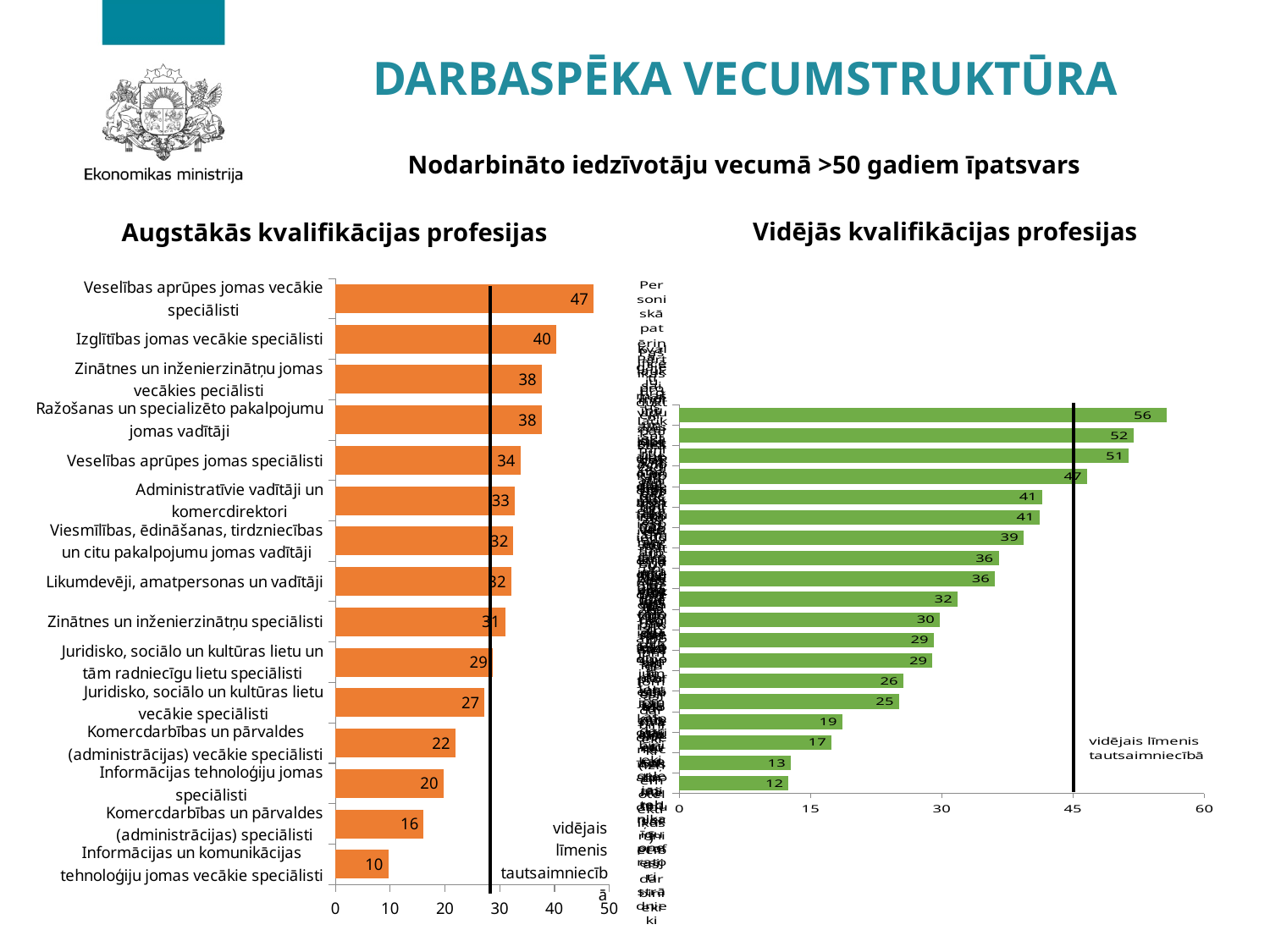
What kind of chart is 'Augstākās kvalifikācijas profesijas'? Bar chart In the chart 'Augstākās kvalifikācijas profesijas', what is the difference between 'Izglītības jomas vecākie speciālisti' and 'Komercdarbības un pārvaldes (administrācijas) speciālisti'? 24 In the chart 'Augstākās kvalifikācijas profesijas', what is the value for 'Veselības aprūpes jomas vecākie speciālisti'? 47 What colour are the bars in the chart 'Vidējās kvalifikācijas profesijas'? Green In the chart 'Augstākās kvalifikācijas profesijas', which is larger: 'Veselības aprūpes jomas speciālisti' or 'Juridisko, sociālo un kultūras lietu vecākie speciālisti'? Veselības aprūpes jomas speciālisti In the chart 'Augstākās kvalifikācijas profesijas', what is the value for 'Informācijas tehnoloģiju jomas speciālisti'? 20 In the chart 'Augstākās kvalifikācijas profesijas', which category has the highest value? Veselības aprūpes jomas vecākie speciālisti In the chart 'Vidējās kvalifikācijas profesijas', what is the lowest value shown? 12 How many categories are shown in the chart 'Augstākās kvalifikācijas profesijas'? 15 How many bars are shown in the chart 'Vidējās kvalifikācijas profesijas'? 19 In the chart 'Vidējās kvalifikācijas profesijas', what is the highest value shown? 56 In the chart 'Augstākās kvalifikācijas profesijas', which category has the lowest value? Informācijas un komunikācijas tehnoloģiju jomas vecākie speciālisti